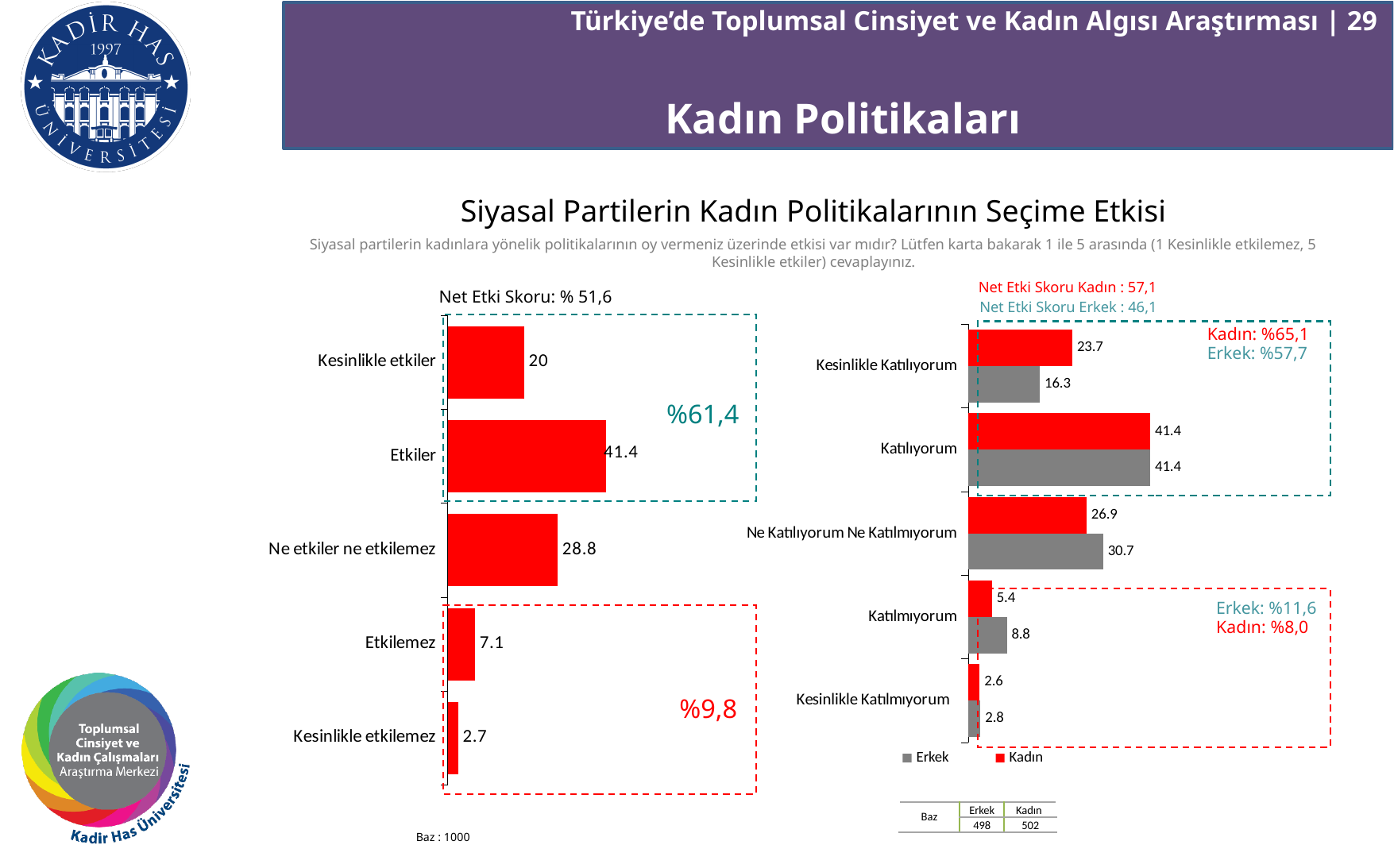
How many series does the legend of the right chart list? 2 How many categories does the left chart show? 5 What kind of chart is the left chart? Bar chart In the right chart, what is the difference between the Kadın and Erkek values for "Kesinlikle Katılıyorum"? 7.4 In the right chart, which colour represents the Kadın series? Red In the left chart, what is the difference between the values for "Ne etkiler ne etkilemez" and "Kesinlikle etkiler"? 8.8 In the left chart, which category has the highest value? Etkiler In the right chart, what is the Erkek value for "Ne Katılıyorum Ne Katılmıyorum"? 30.7 In the right chart, which is larger for "Katılmıyorum": the Erkek value or the Kadın value? Erkek In the left chart, which category has the lowest value? Kesinlikle etkilemez In the right chart, what is the Kadın value for "Kesinlikle Katılıyorum"? 23.7 In the left chart, what is the value for "Etkiler"? 41.4